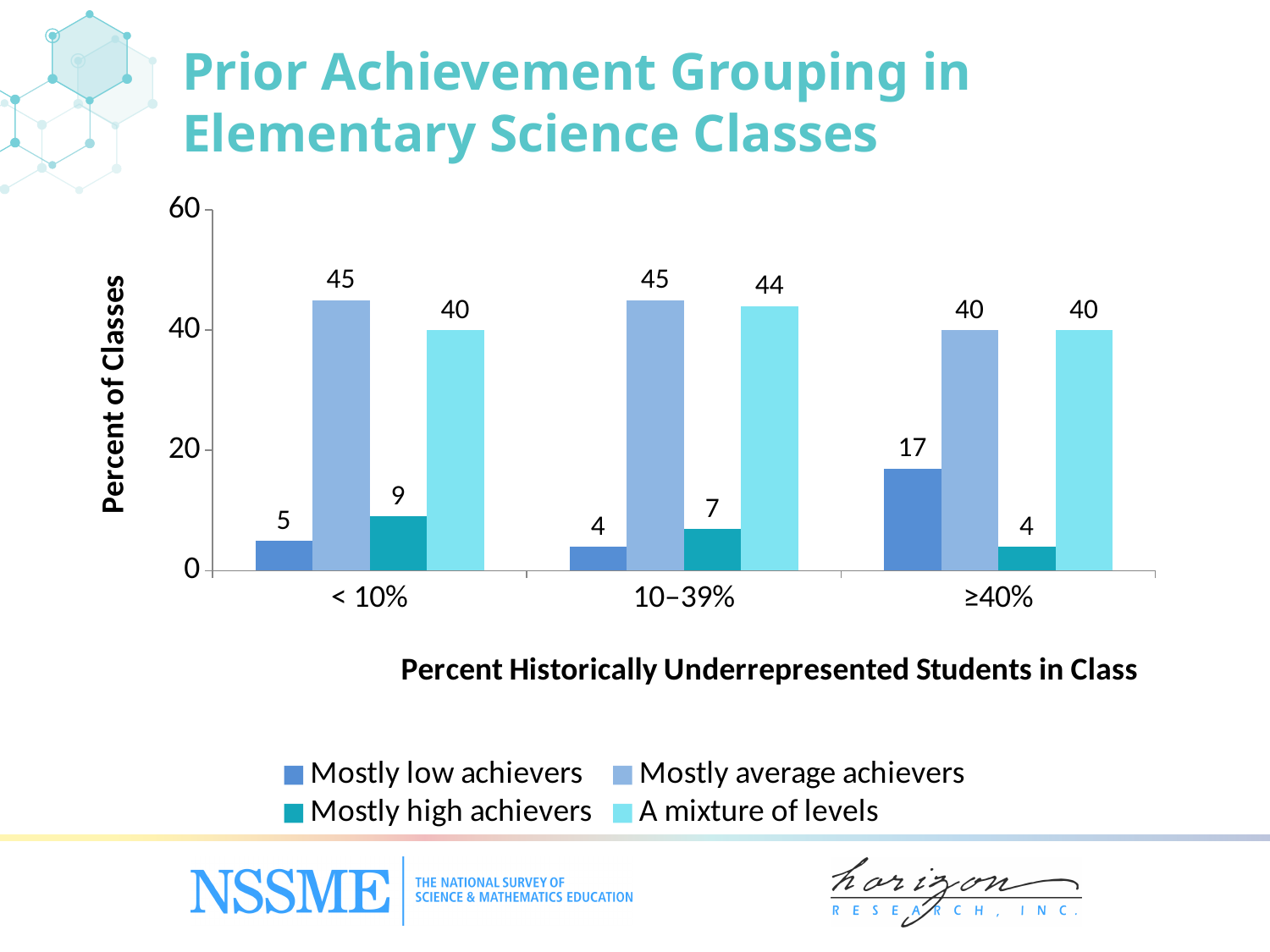
What kind of chart is shown on the slide? Bar chart What is the value for 'A mixture of levels' in the 10–39% category? 44 What is the label of the y axis? Percent of Classes What is the difference between 'Mostly average achievers' and 'Mostly low achievers' in the ≥40% category? 23 In the < 10% category, which is larger: 'Mostly average achievers' or 'A mixture of levels'? Mostly average achievers What is the value for 'Mostly high achievers' in the ≥40% category? 4 Which category has the highest value for 'Mostly low achievers'? ≥40% How many series does the legend list? 4 Which category has the lowest value for 'Mostly high achievers'? ≥40% What percent of classes with < 10% historically underrepresented students are grouped as mostly low achievers? 5 Is the value for 'Mostly low achievers' in the ≥40% category greater or less than 20? less How many categories are shown on the x axis? 3